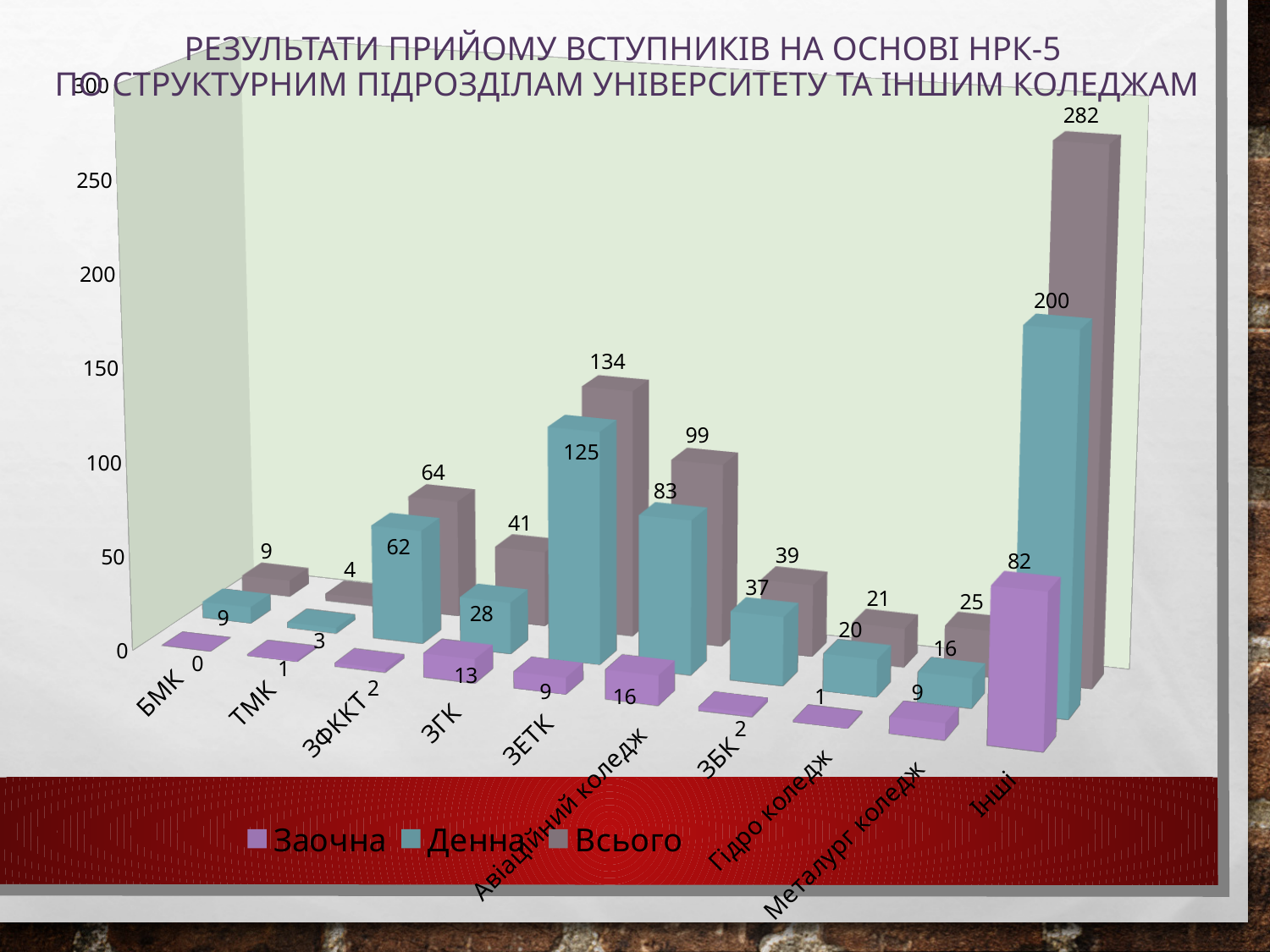
Which category has the lowest Всього value? ТМК How many categories are shown on the x axis? 10 Which category has the highest Всього value? Інші How many series does the legend list? 3 Which is larger, the Денна value for ЗГК or the Денна value for ЗБК? ЗБК Which series is shown in purple in the legend? Заочна What is the Всього value for ЗЕТК? 134 What is the Денна value for ЗФККТ? 62 What is the difference between the Всього values for Інші and ЗЕТК? 148 What is the Заочна value for Інші? 82 What kind of chart is shown on the slide? bar chart What is the Денна value for Авіаційний коледж? 83